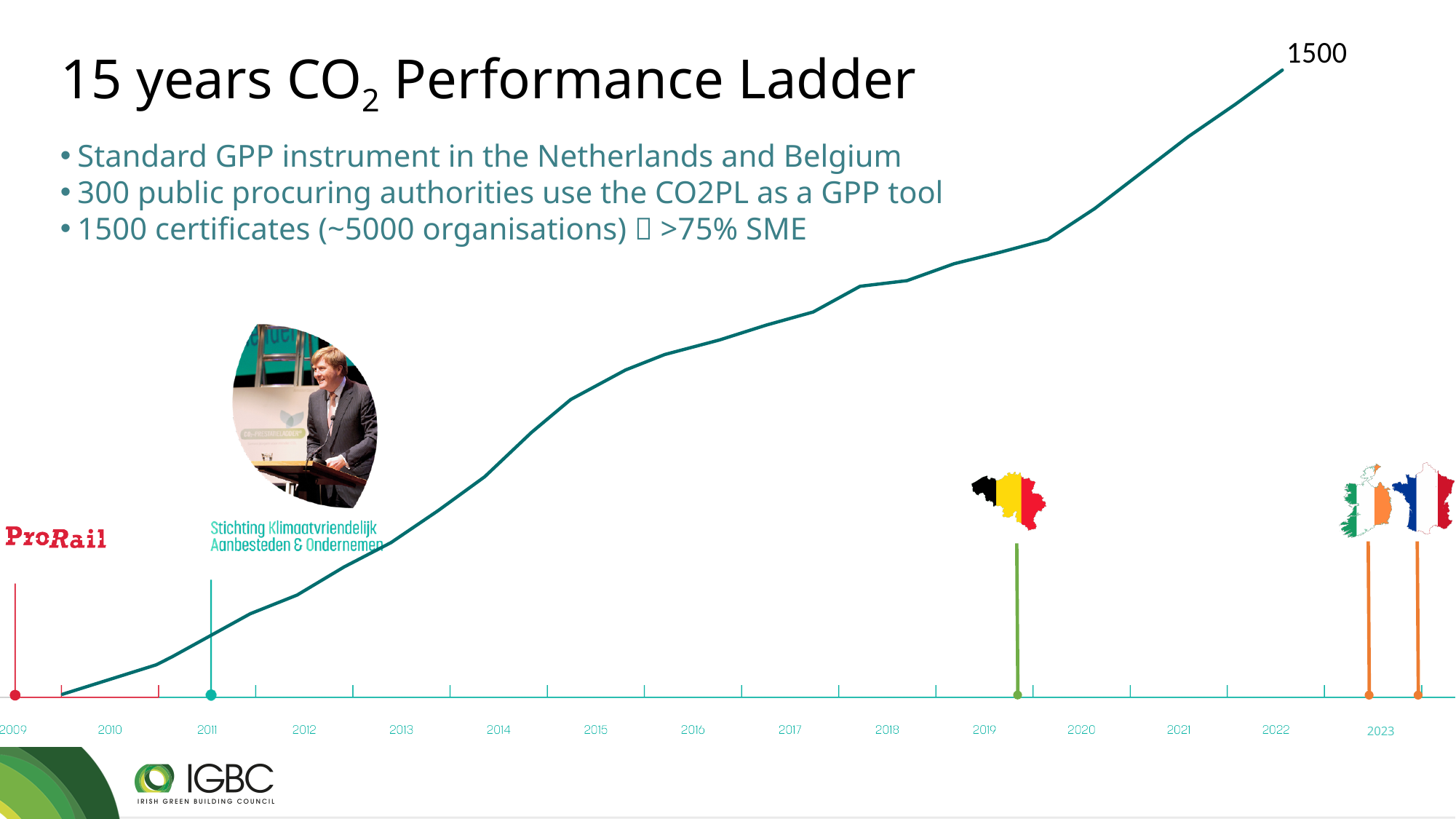
What kind of chart is shown on the slide? line chart Which year has the larger value on the line, 2012 or 2015? 2015 Which year has the larger value on the line, 2020 or 2016? 2020 How many year labels are shown along the x axis? 15 What is the first year shown on the x axis? 2009 Which country's map is shown above the 2019 marker on the timeline? Belgium What is the title of the slide containing the chart? 15 years CO2 Performance Ladder Which year on the x axis has the highest value on the line? 2023 What value is labelled at the end of the line in 2023? 1500 Do the values on the line rise or fall from 2009 to 2023? rise